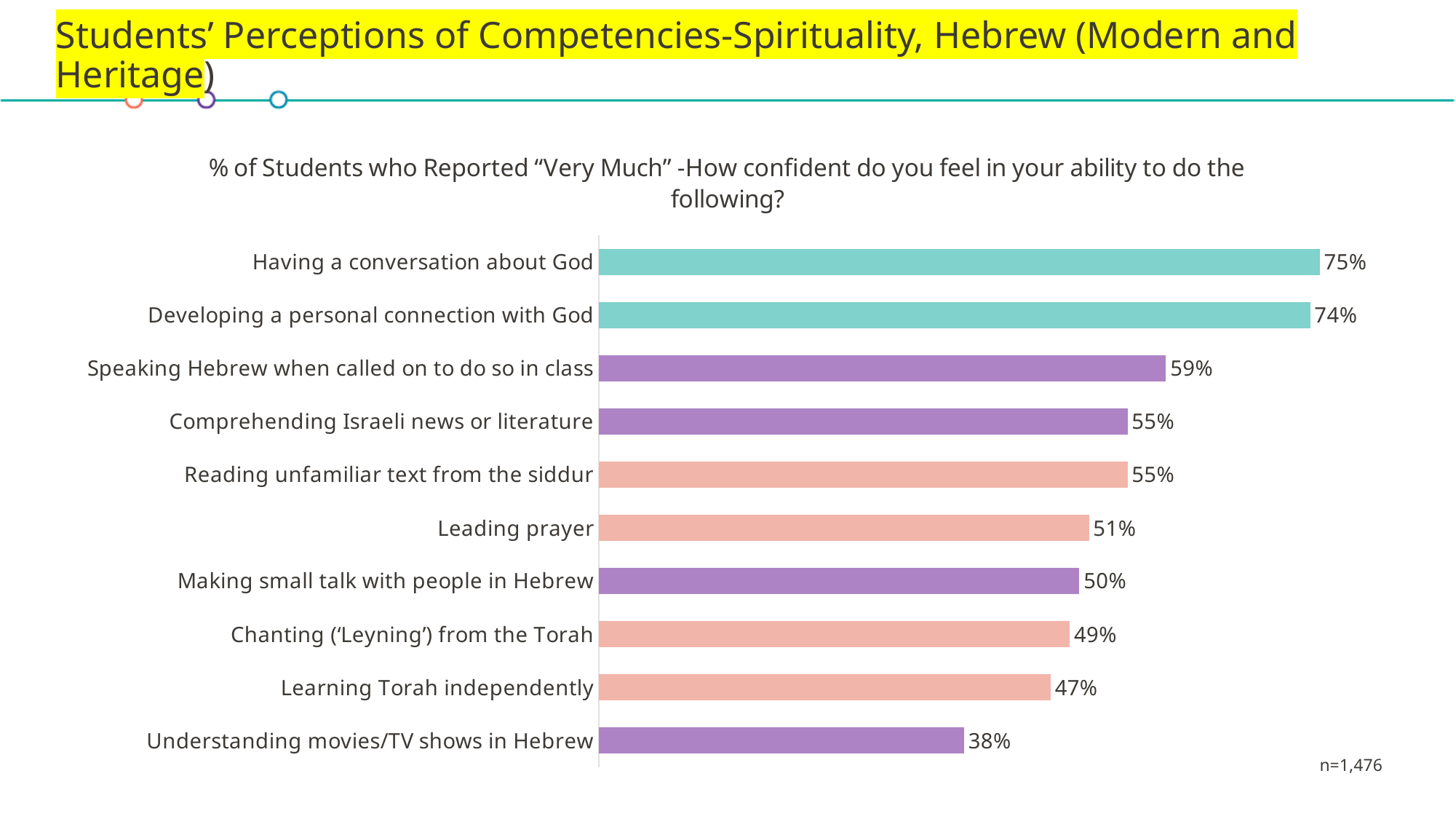
What sample size (n) is noted on the chart? n=1,476 What is the difference between the values for "Having a conversation about God" and "Understanding movies/TV shows in Hebrew"? 37% Which is larger: the value for "Leading prayer" or the value for "Learning Torah independently"? Leading prayer What is the value for "Understanding movies/TV shows in Hebrew"? 38% What is the difference between "Speaking Hebrew when called on to do so in class" and "Making small talk with people in Hebrew"? 9% Which category has the lowest value? Understanding movies/TV shows in Hebrew What is the value for "Speaking Hebrew when called on to do so in class"? 59% What percentage of students reported "Very Much" confidence in having a conversation about God? 75% What type of chart is shown on the slide? Bar chart How many categories are shown in the chart? 10 Which category has the highest value? Having a conversation about God What is the value for "Leading prayer"? 51%